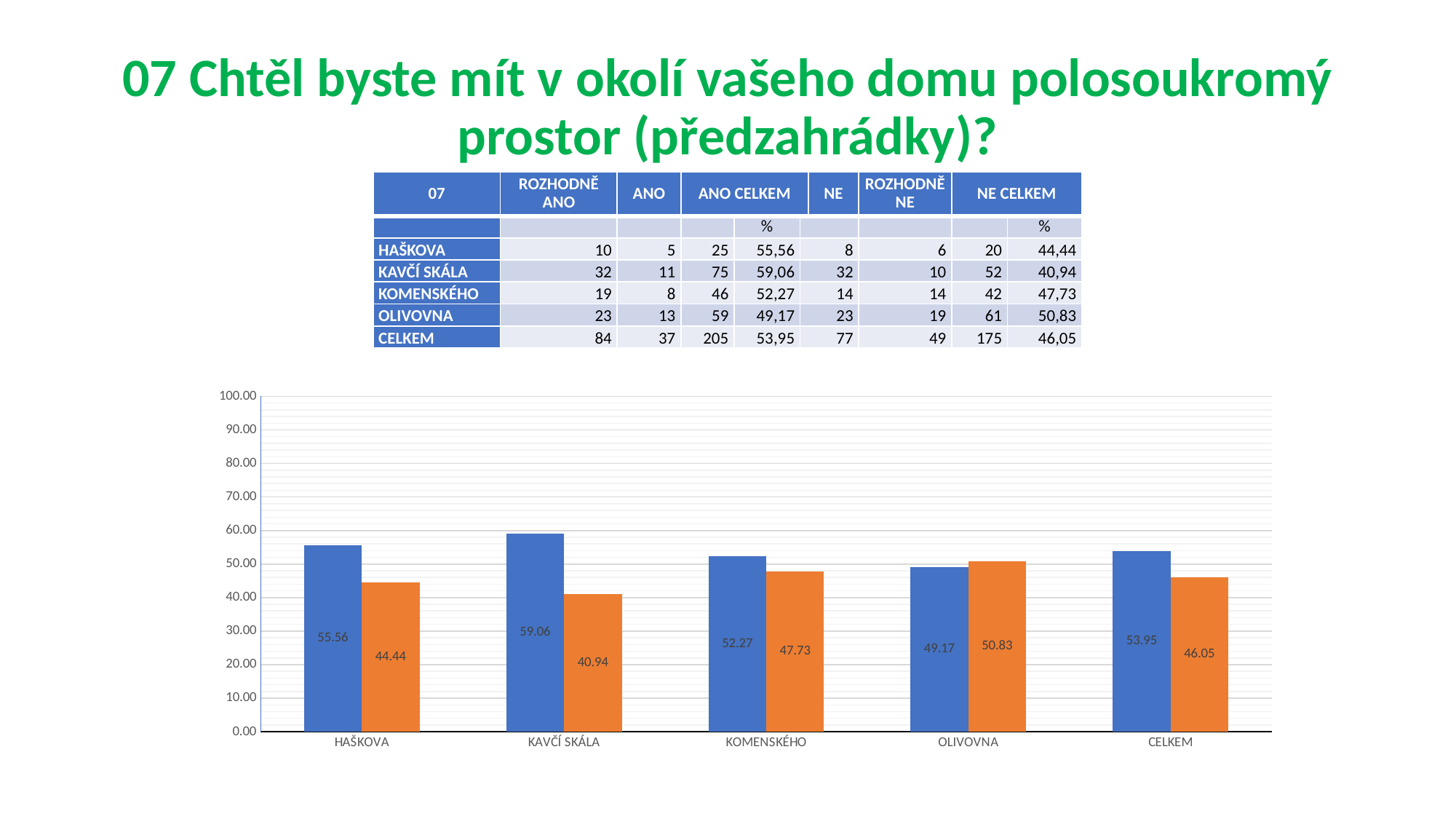
Is the value of the blue bar for KAVČÍ SKÁLA greater or less than 50.00? greater What is the value of the blue bar for HAŠKOVA? 55.56 How many categories are shown on the x axis of the chart? 5 Which category has the lowest orange bar? KAVČÍ SKÁLA What is the highest value shown on the chart's vertical axis? 100.00 What is the difference between the blue and orange bars for KOMENSKÉHO? 4.54 What kind of chart is shown on the slide? bar chart What is the value of the orange bar for KAVČÍ SKÁLA? 40.94 Which category has the highest blue bar? KAVČÍ SKÁLA What is the value of the orange bar for OLIVOVNA? 50.83 What is the value of the blue bar for CELKEM? 53.95 For OLIVOVNA, which is larger, the blue bar or the orange bar? the orange bar